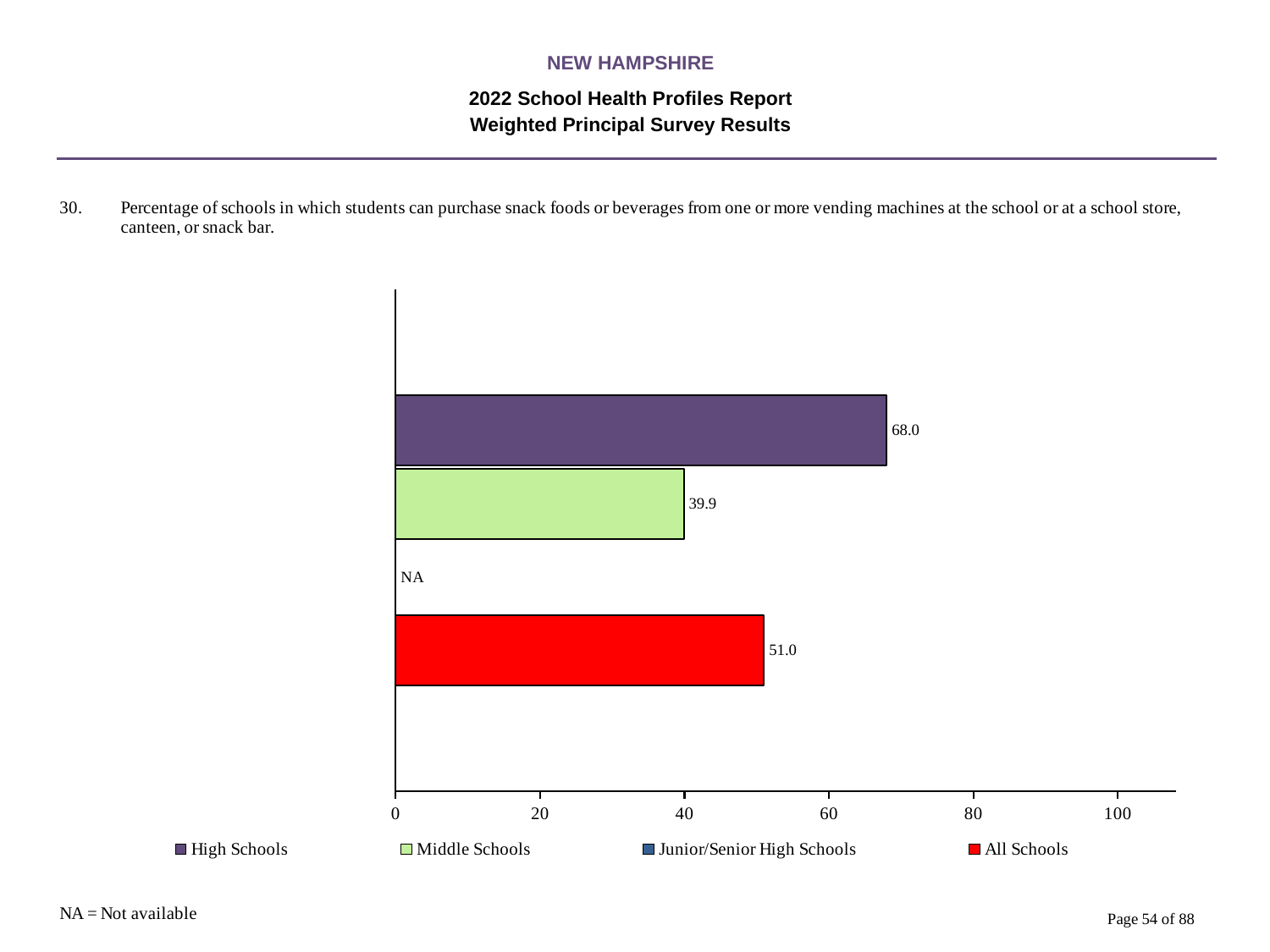
What is the difference between the High Schools value and the Middle Schools value? 28.1 What is the value for High Schools? 68.0 What is the value for Middle Schools? 39.9 What is the value for All Schools? 51.0 Which school type has the highest value? High Schools What kind of chart is shown on the slide? Bar chart What is the difference between the High Schools value and the All Schools value? 17.0 What is shown for Junior/Senior High Schools? NA Is the value for High Schools greater or less than 60? greater How many series does the legend list? 4 Which is larger, the value for Middle Schools or the value for All Schools? All Schools Which school type with a plotted value has the lowest value? Middle Schools